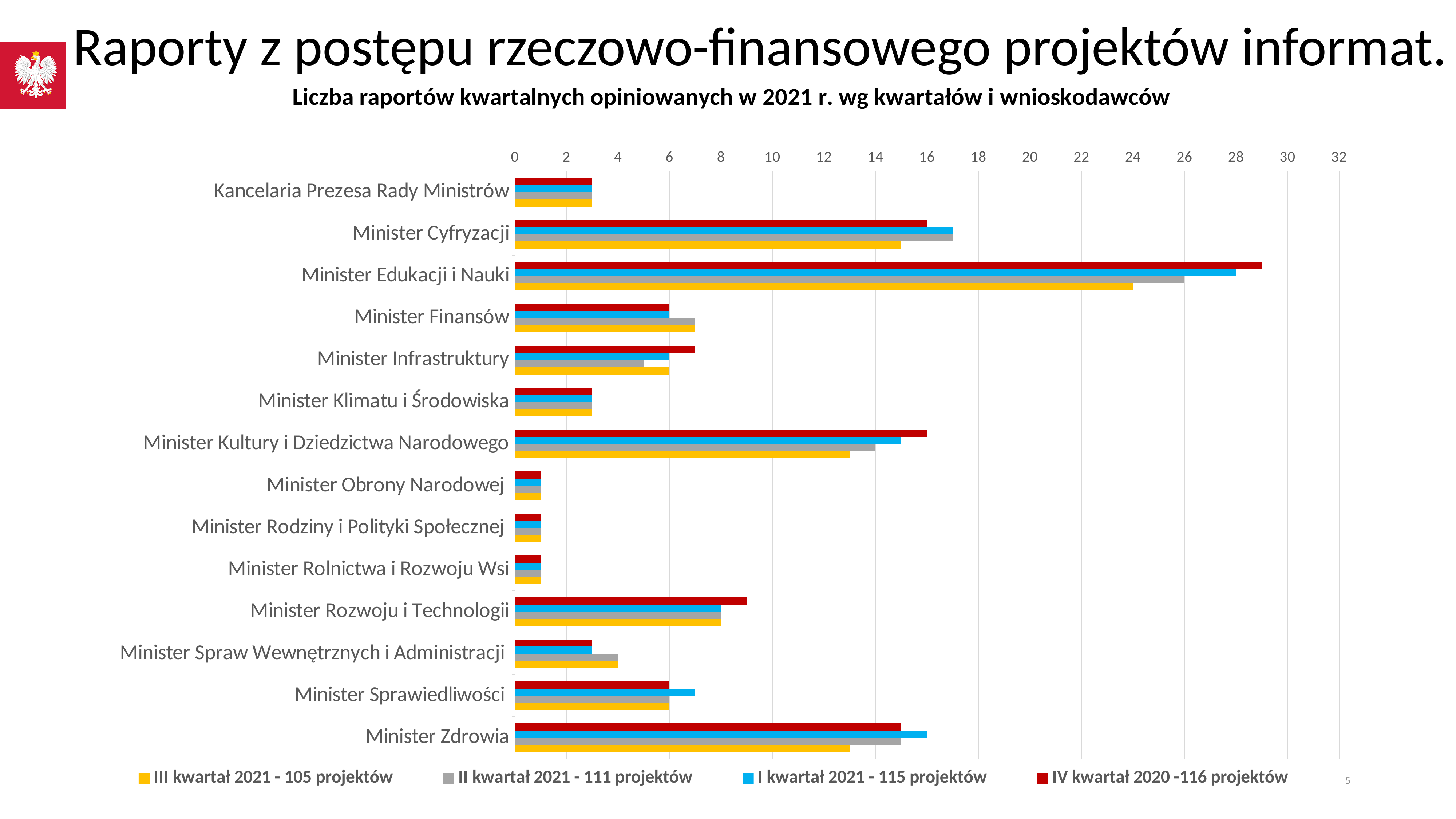
What is the value for Minister Cyfryzacji in the series 'IV kwartał 2020 -116 projektów'? 16 How many series does the legend list? 4 For the series 'I kwartał 2021 - 115 projektów', which is larger: Minister Zdrowia or Minister Sprawiedliwości? Minister Zdrowia What type of chart is shown on the slide? bar chart Which category has the highest value for the series 'IV kwartał 2020 -116 projektów'? Minister Edukacji i Nauki What is the value for Minister Edukacji i Nauki in the series 'I kwartał 2021 - 115 projektów'? 28 What is the difference between the 'I kwartał 2021 - 115 projektów' and 'III kwartał 2021 - 105 projektów' values for Minister Edukacji i Nauki? 4 What is the value for Minister Zdrowia in the series 'I kwartał 2021 - 115 projektów'? 16 Is the value for Minister Edukacji i Nauki in the series 'IV kwartał 2020 -116 projektów' greater or less than 28? greater Which legend entry is shown in yellow? III kwartał 2021 - 105 projektów What is the value for Minister Edukacji i Nauki in the series 'III kwartał 2021 - 105 projektów'? 24 How many applicant categories are shown on the chart? 14